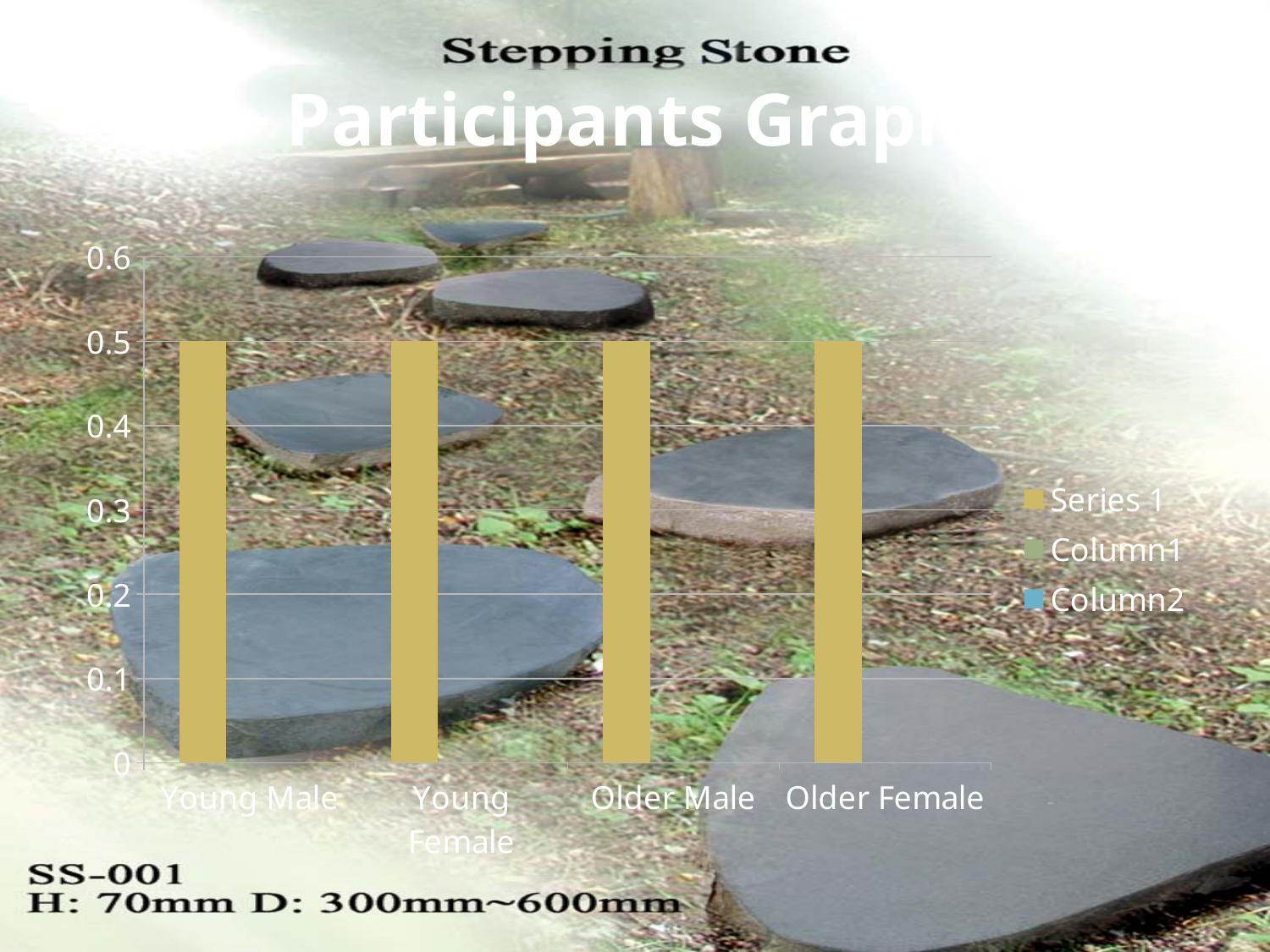
What is the value for Older Female in the chart? 0.5 How many categories are shown on the x axis of the chart? 4 How many series does the chart's legend list? 3 What is the difference between the values for Young Male and Older Female? 0 What is the title of the chart on the slide? Participants Graph What is the name of the first series listed in the chart's legend? Series 1 What is the value for Older Male in the chart? 0.5 What kind of chart is shown on the slide? bar chart Is the value for Young Female greater or less than 0.6? less What is the value for Young Female in the chart? 0.5 What is the value for Young Male in the chart? 0.5 Is the value for Older Male greater or less than 0.4? greater